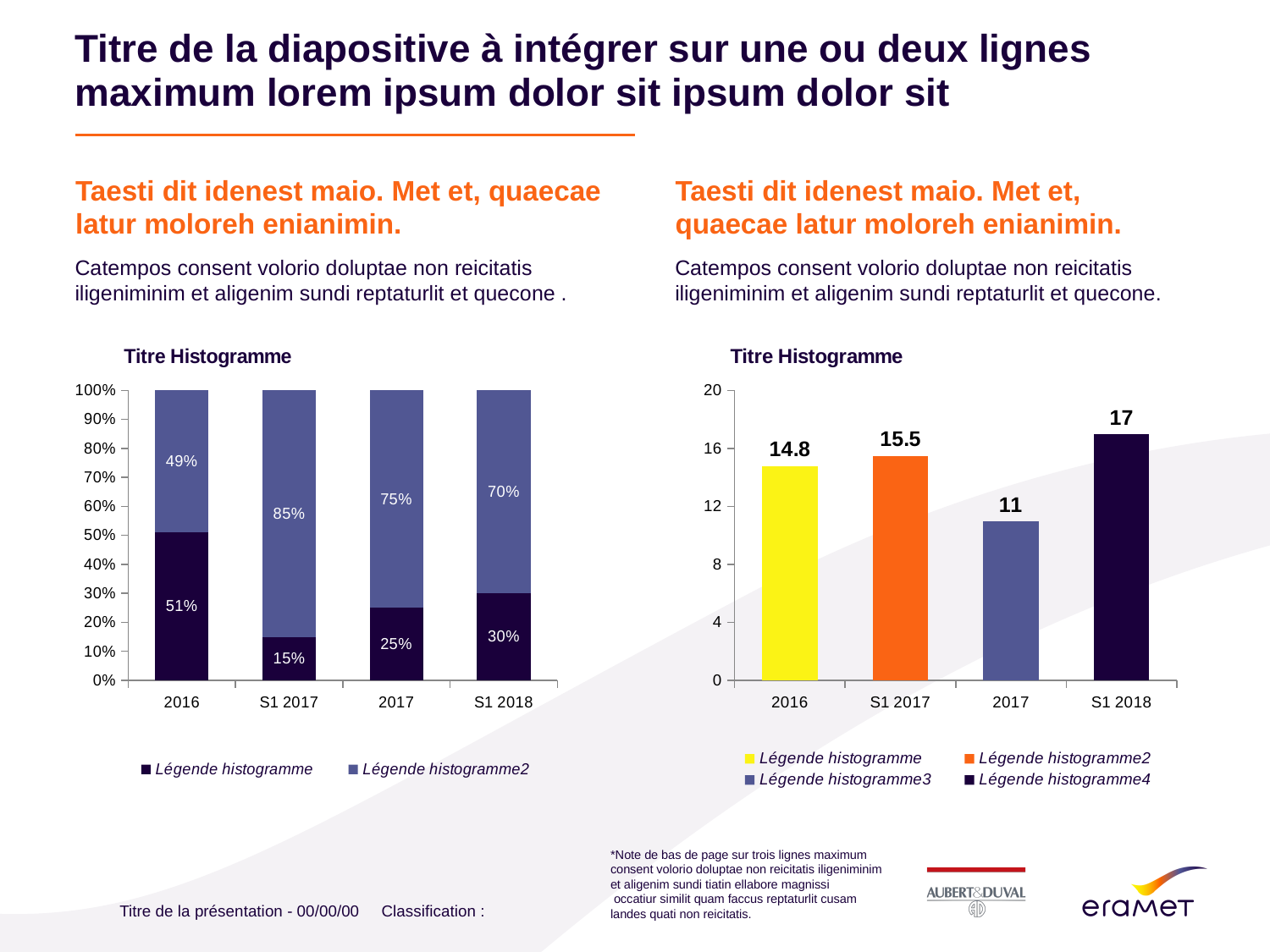
In the left chart, what is the value of Légende histogramme for 2016? 51% What kind of chart is the right chart? Bar chart How many series does the legend of the right chart list? 4 In the right chart, which category has the highest value? S1 2018 In the right chart, what is the value for S1 2017? 15.5 In the left chart, what is the value of Légende histogramme2 for S1 2017? 85% In the left chart, which category has the lowest value for Légende histogramme? S1 2017 In the left chart, what is the difference between Légende histogramme2 and Légende histogramme for 2017? 50% In the left chart, which is larger for S1 2018: Légende histogramme or Légende histogramme2? Légende histogramme2 In the right chart, what is the difference between the values for S1 2018 and 2017? 6 How many series does the legend of the left chart list? 2 In the right chart, which category has the lowest value? 2017